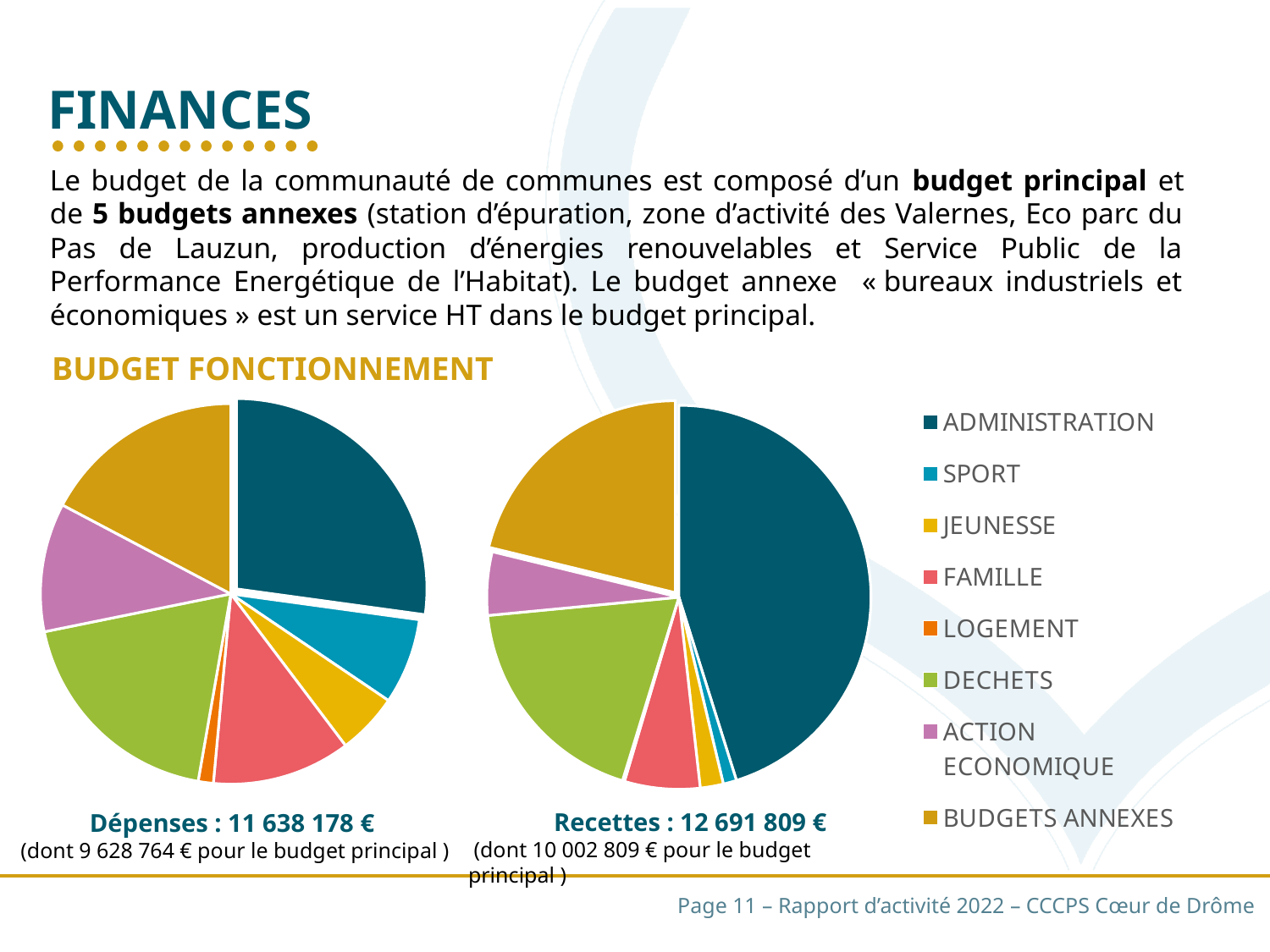
What kind of charts are shown on the slide? Pie charts In the Recettes pie chart, which slice is larger, DECHETS or FAMILLE? DECHETS In the Dépenses pie chart, which category has the smallest slice? LOGEMENT In the Dépenses pie chart, which slice is larger, FAMILLE or SPORT? FAMILLE In the Dépenses pie chart, which category has the largest slice? ADMINISTRATION What total amount is shown under the Dépenses pie chart? 11 638 178 € How many categories does the legend list for the pie charts? 8 In the Recettes pie chart, which category has the largest slice? ADMINISTRATION In the Dépenses pie chart, how many slices are there? 8 In the Recettes pie chart, which slice is larger, BUDGETS ANNEXES or ACTION ECONOMIQUE? BUDGETS ANNEXES In the Recettes pie chart, which category has the smallest slice? LOGEMENT What is the heading above the two pie charts? BUDGET FONCTIONNEMENT